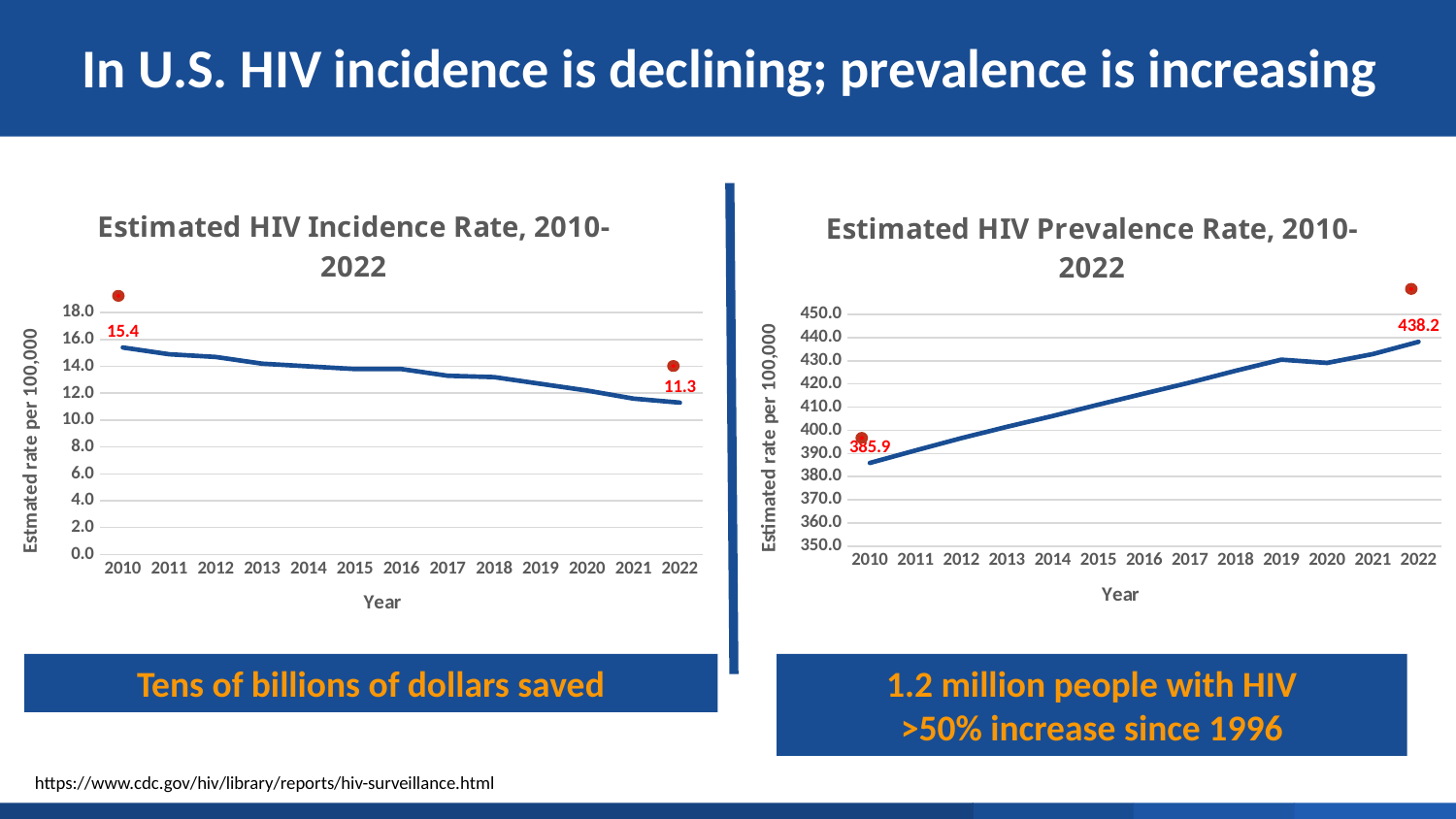
In the Estimated HIV Prevalence Rate chart, is the value for 2016 greater or less than 400.0? greater In the Estimated HIV Incidence Rate chart, do the values rise or fall from 2010 to 2022? fall In the Estimated HIV Prevalence Rate chart, what is the difference between the 2022 and 2010 values? 52.3 In the Estimated HIV Prevalence Rate chart, do the values rise or fall from 2010 to 2022? rise In the Estimated HIV Incidence Rate chart, what is the value for 2022? 11.3 How many years are plotted on the x axis of the Estimated HIV Incidence Rate chart? 13 In the Estimated HIV Prevalence Rate chart, what is the value for 2010? 385.9 What kind of chart is the Estimated HIV Prevalence Rate chart? line chart In the Estimated HIV Incidence Rate chart, what is the difference between the 2010 and 2022 values? 4.1 In the Estimated HIV Prevalence Rate chart, what is the value for 2022? 438.2 In the Estimated HIV Incidence Rate chart, what is the value for 2010? 15.4 In the Estimated HIV Incidence Rate chart, which year has the lowest value, 2010 or 2022? 2022